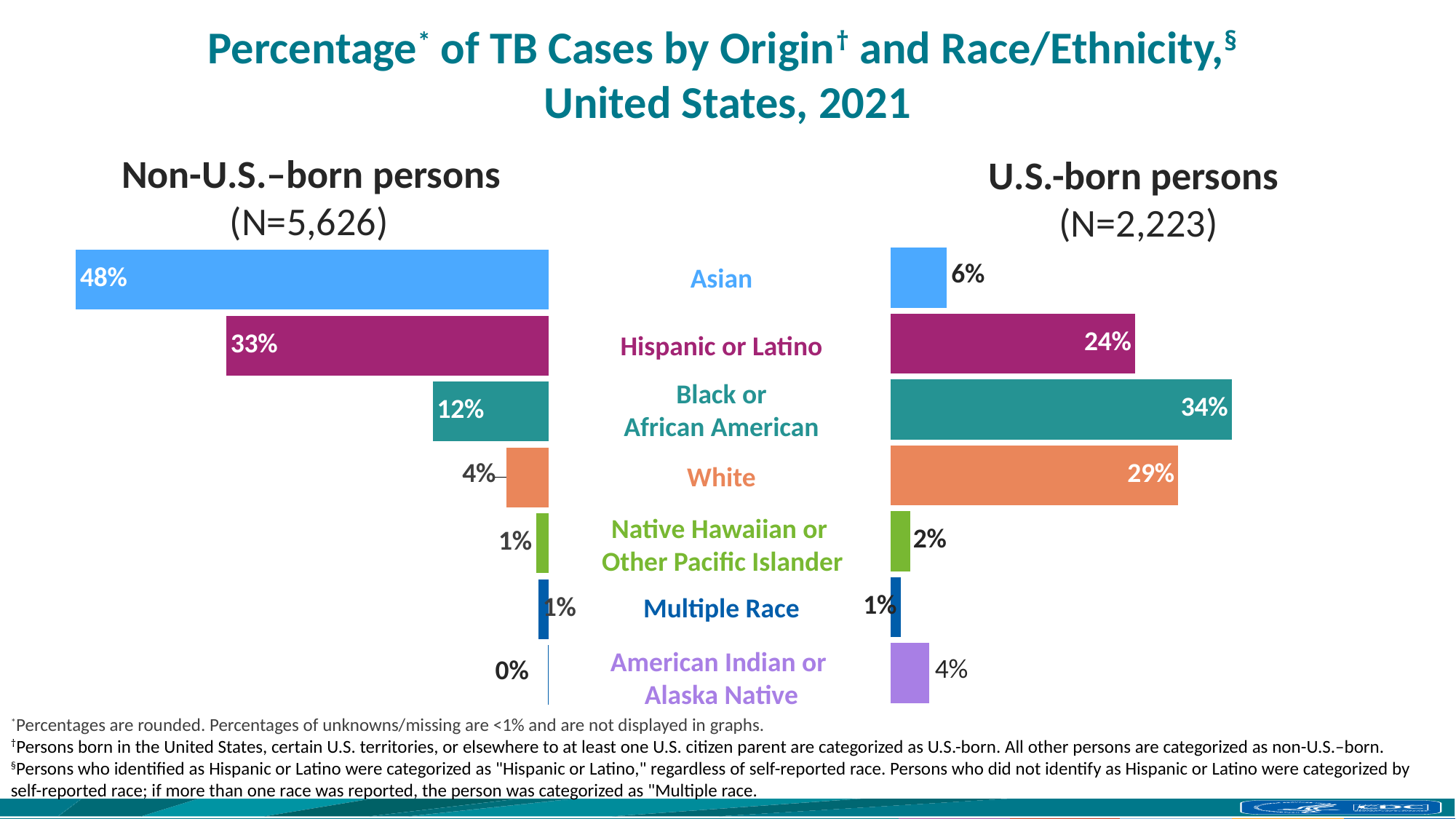
In the Non-U.S.-born persons chart, what percentage of TB cases is for Asian persons? 48% What type of chart is used on this slide? Bar chart In the U.S.-born persons chart, what percentage of TB cases is for White persons? 29% How many race/ethnicity categories are shown in each chart? 7 In the Non-U.S.-born persons chart, which race/ethnicity category has the highest percentage? Asian In the U.S.-born persons chart, what is the difference between the Black or African American percentage and the Hispanic or Latino percentage? 10% What is the difference between the Asian percentage in the Non-U.S.-born persons chart and the Asian percentage in the U.S.-born persons chart? 42% In the U.S.-born persons chart, what percentage of TB cases is for Black or African American persons? 34% Which is larger: the White percentage in the Non-U.S.-born persons chart or the White percentage in the U.S.-born persons chart? U.S.-born persons In the Non-U.S.-born persons chart, which race/ethnicity category has the lowest percentage? American Indian or Alaska Native In the Non-U.S.-born persons chart, what percentage of TB cases is for Hispanic or Latino persons? 33% In the U.S.-born persons chart, which race/ethnicity category has the highest percentage? Black or African American